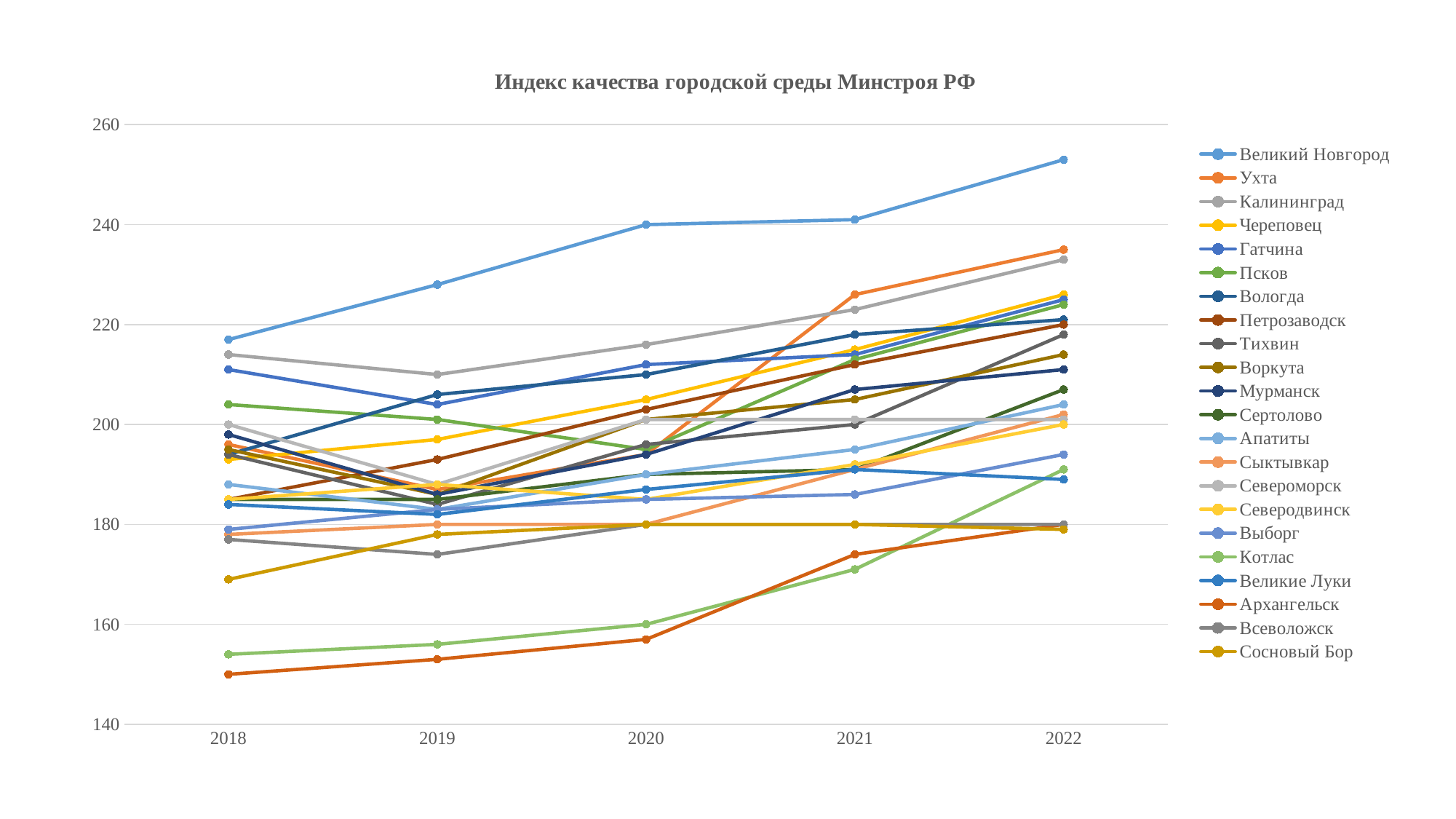
Which city has the lowest value in 2018? Архангельск What is the value for Великий Новгород in 2020? 240 What kind of chart is shown on the slide? line chart Is the value for Архангельск in 2018 greater or less than 160? less Does the value for Великий Новгород rise or fall from 2018 to 2022? rise How many series does the legend list? 22 What is the title of the chart? Индекс качества городской среды Минстроя РФ Is the value for Великий Новгород in 2022 greater or less than 240? greater Which is larger in 2022, the value for Великий Новгород or the value for Ухта? Великий Новгород Is the value for Ухта in 2022 greater or less than 220? greater How many years are shown along the x axis? 5 Which city has the highest value in 2022? Великий Новгород